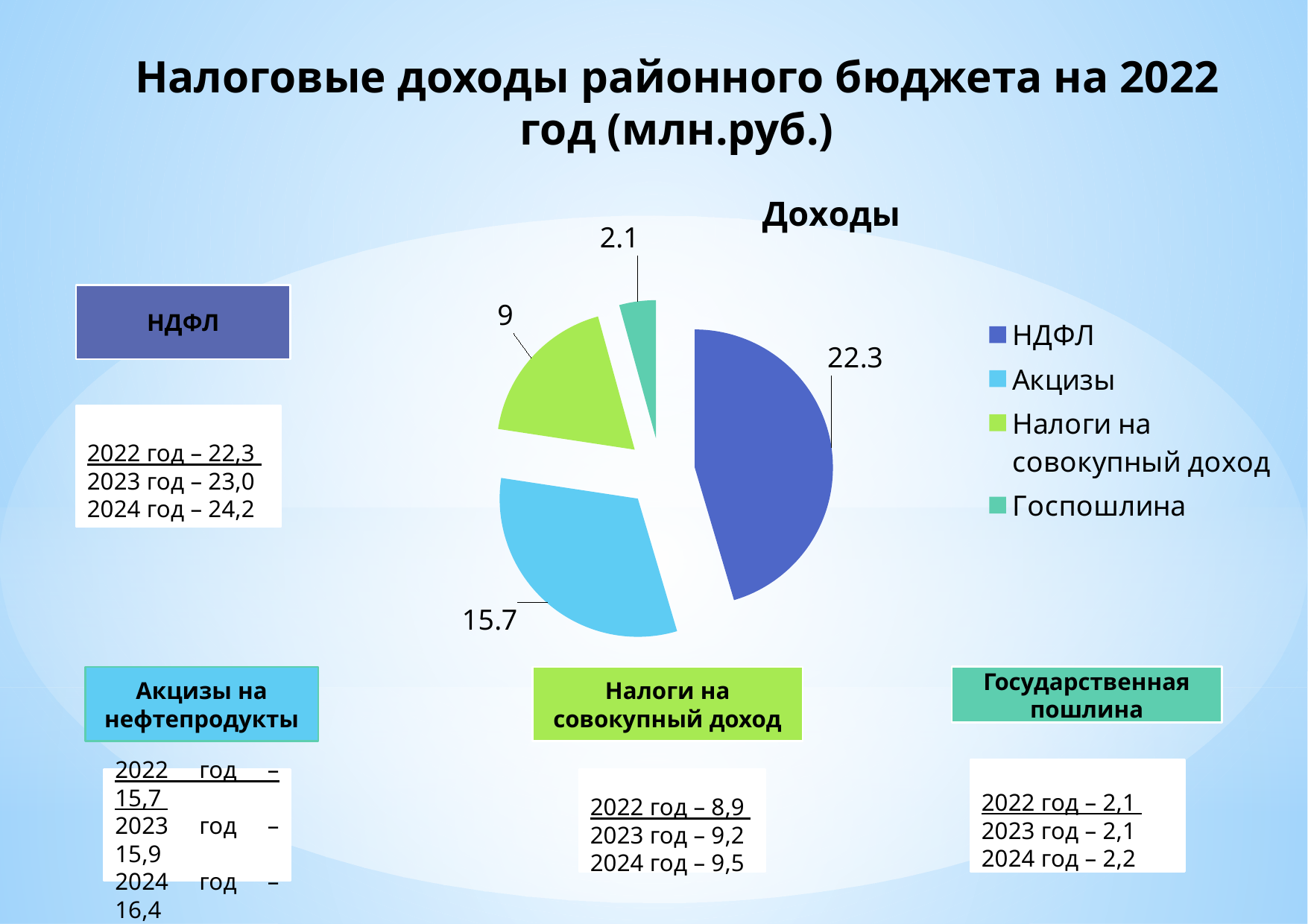
Which category has the smallest slice in the Доходы pie chart? Госпошлина What is the difference between the НДФЛ and Акцизы values in the Доходы pie chart? 6.6 How many slices does the Доходы pie chart have? 4 Which is larger in the Доходы pie chart: Акцизы or Налоги на совокупный доход? Акцизы What is the value of the Госпошлина slice in the Доходы pie chart? 2.1 What type of chart is shown on the slide? Pie chart What is the total of all slices in the Доходы pie chart? 49.1 What is the title of the chart on the slide? Доходы What is the value of the Налоги на совокупный доход slice in the Доходы pie chart? 9 What is the value of the Акцизы slice in the Доходы pie chart? 15.7 Which category has the largest slice in the Доходы pie chart? НДФЛ What is the value of the НДФЛ slice in the Доходы pie chart? 22.3